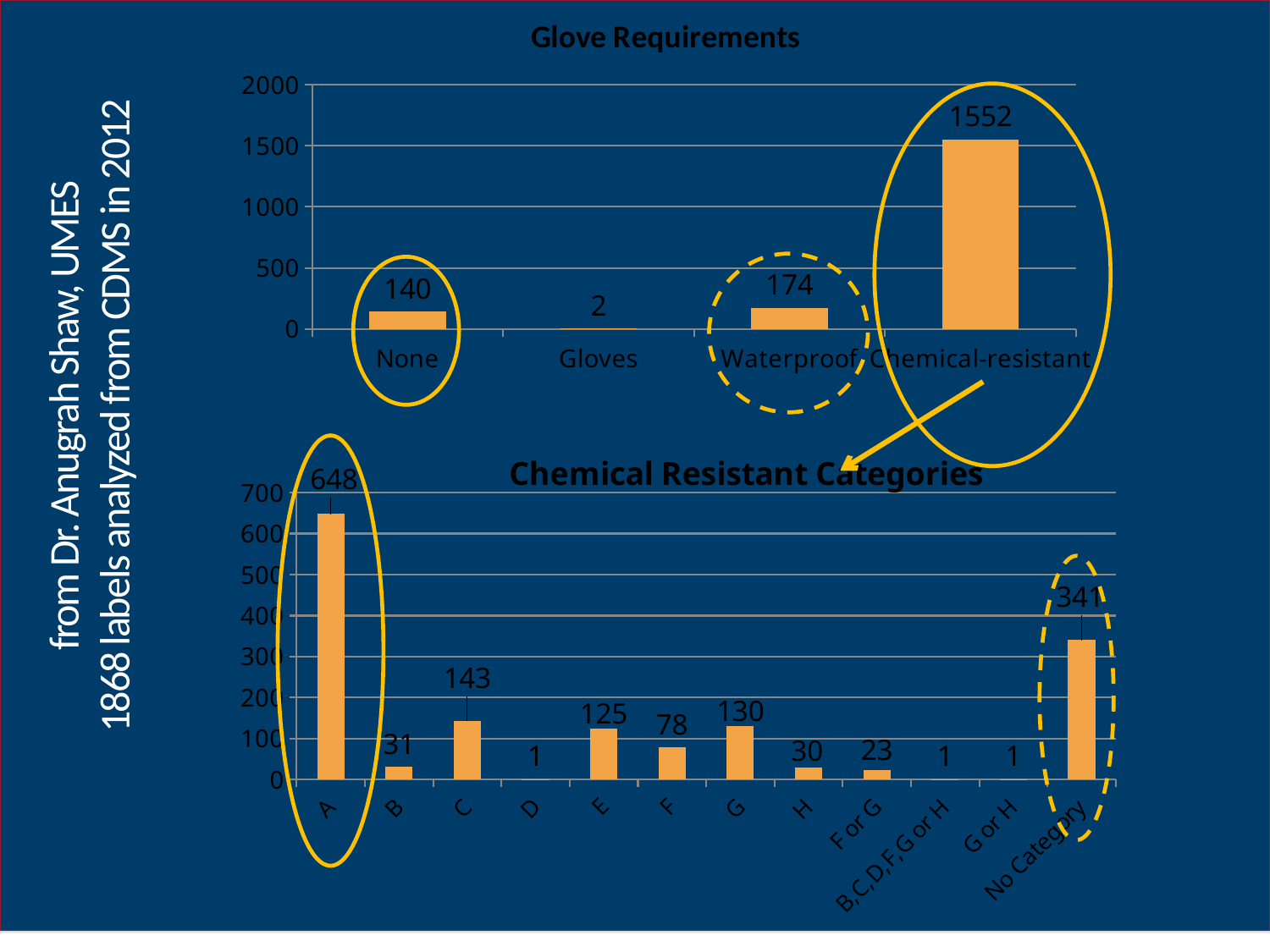
In the Glove Requirements chart, what is the difference between the Waterproof and None values? 34 In the Glove Requirements chart, how many categories are shown? 4 In the Chemical Resistant Categories chart, what is the value for category A? 648 In the Chemical Resistant Categories chart, what is the difference between the values for E and F? 47 What kind of chart is the Chemical Resistant Categories chart? Bar chart In the Glove Requirements chart, which category has the lowest value? Gloves In the Chemical Resistant Categories chart, how many categories are shown on the x axis? 12 In the Glove Requirements chart, what is the value for Chemical-resistant? 1552 In the Chemical Resistant Categories chart, which is larger, the value for C or the value for G? C In the Glove Requirements chart, what is the value for Waterproof? 174 In the Chemical Resistant Categories chart, which category has the highest value? A In the Chemical Resistant Categories chart, what is the value for No Category? 341